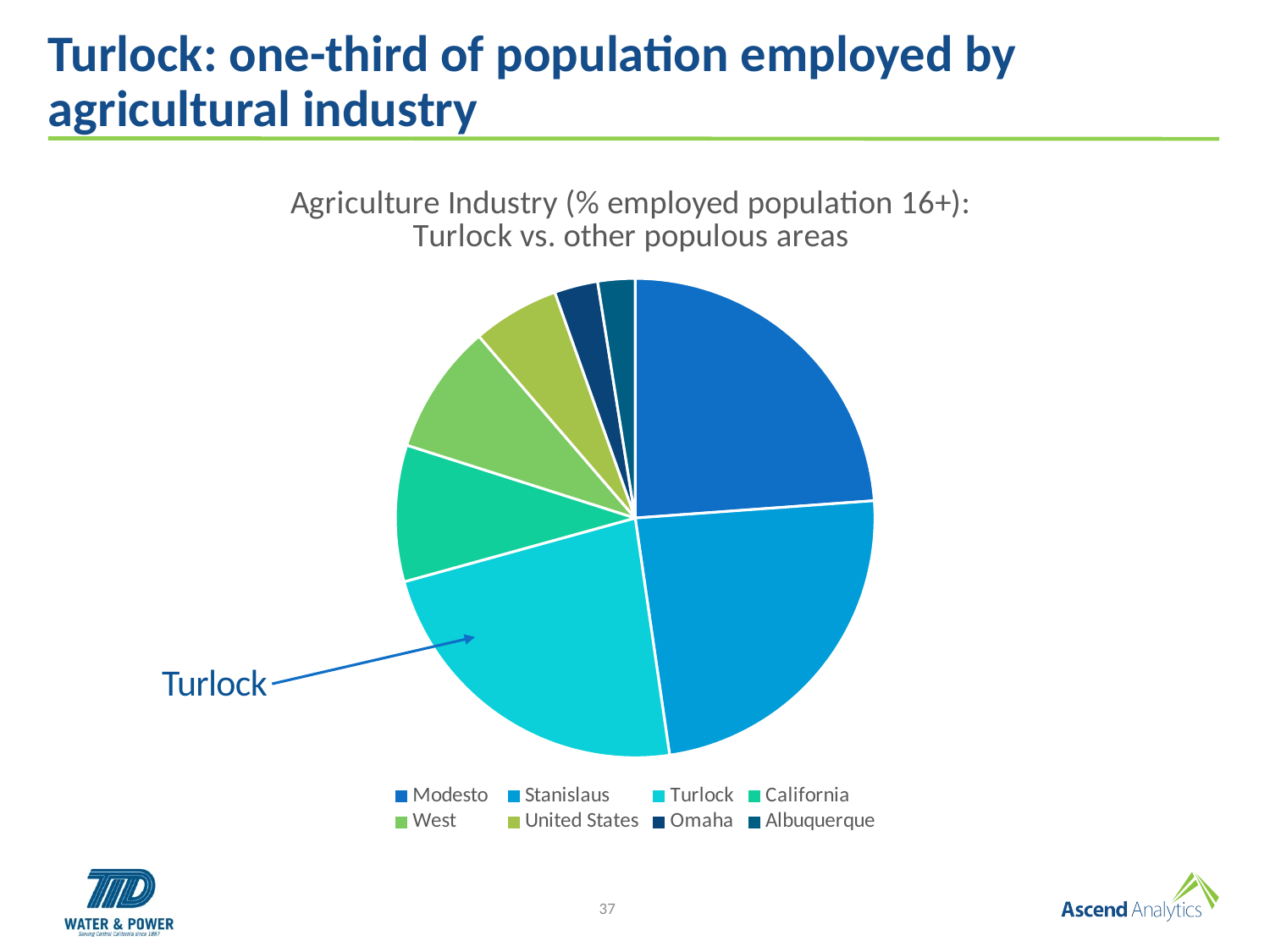
What is the title of the chart? Agriculture Industry (% employed population 16+): Turlock vs. other populous areas Which slice is larger, Turlock or West? Turlock What kind of chart is shown on the slide? pie chart Which slice is larger, Stanislaus or Albuquerque? Stanislaus Which slice is larger, West or Omaha? West How many categories (slices) does the pie chart have? 8 Which slice of the pie chart is pointed out with an arrow and label? Turlock